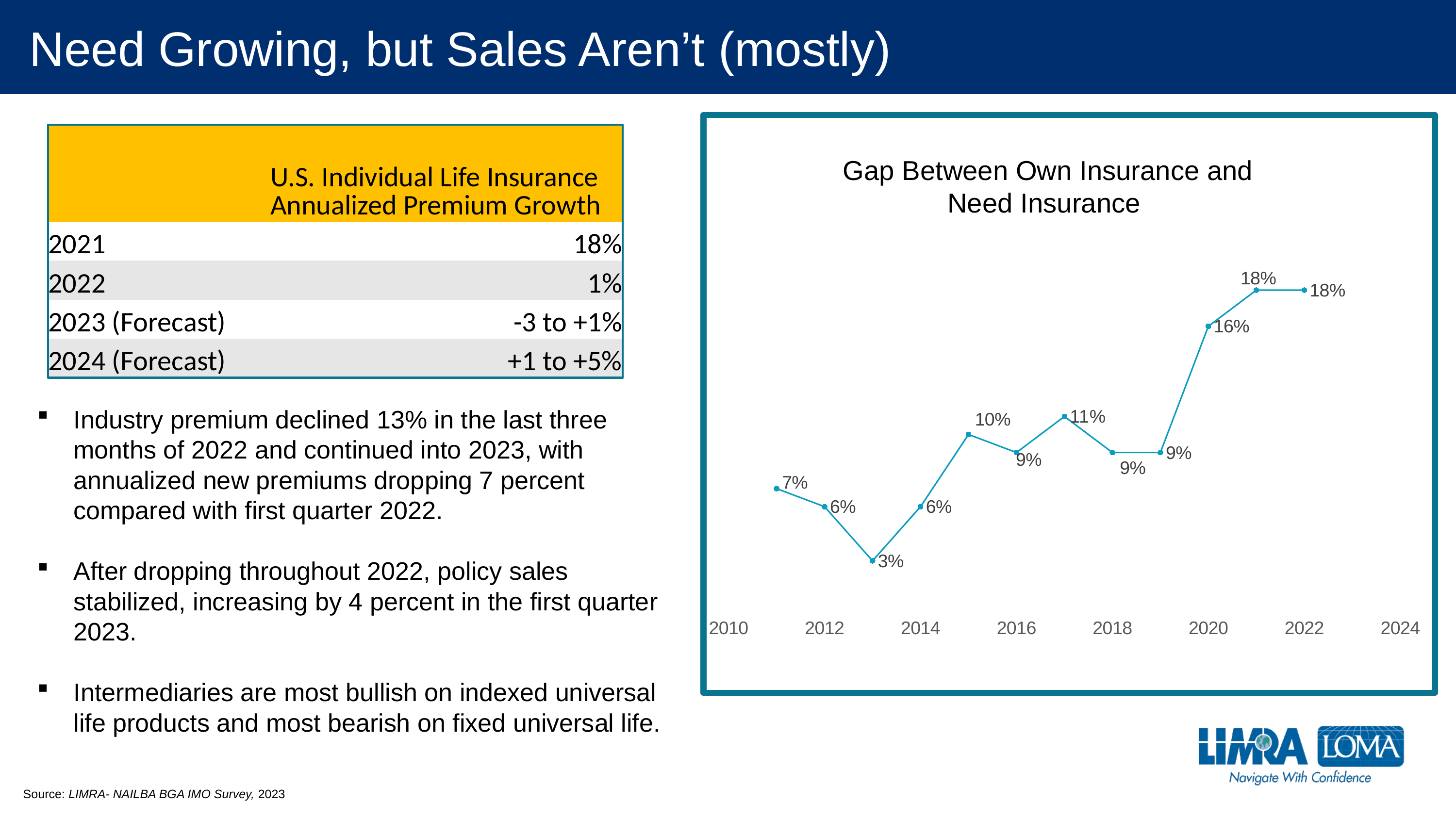
What is the highest value plotted on the chart? 18% Which year has the larger value, 2018 or 2020? 2020 What is the value plotted for 2020? 16% Overall, do the values rise or fall from the first point to the last point along the x axis? rise How many data points are plotted on the line? 12 What is the value plotted for 2022? 18% What is the value plotted for 2012? 6% What is the value plotted for 2016? 9% What kind of chart is shown on the slide? line chart What is the title of the chart on the slide? Gap Between Own Insurance and Need Insurance What is the lowest value plotted on the chart? 3% By how many percentage points does the 2022 value exceed the 2012 value? 12 percentage points